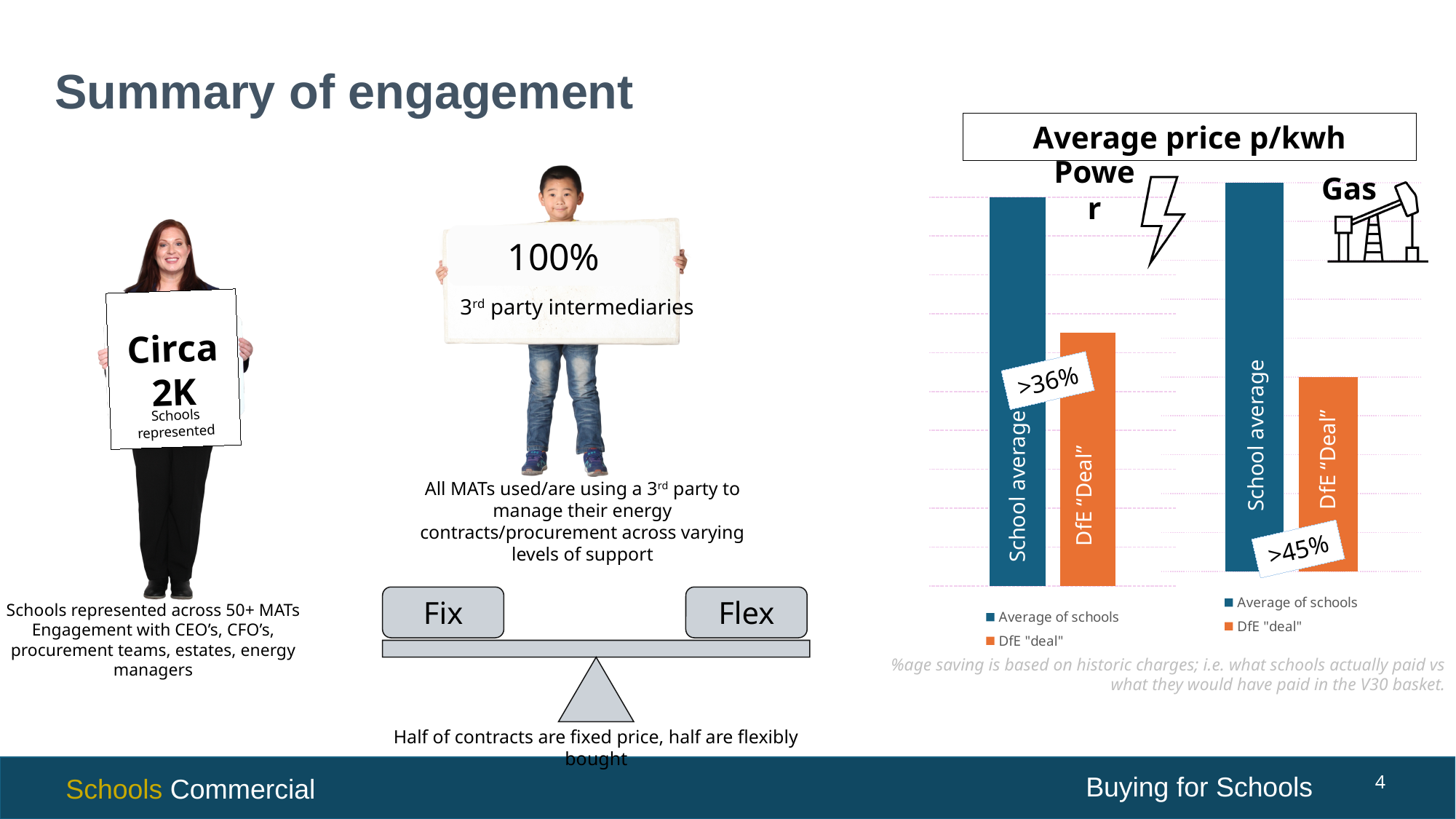
How many series does the legend of the Power chart list? 2 In the Power chart, which bar is the lowest? DfE "Deal" How many series does the legend of the Gas chart list? 2 In the Power chart, which bar is taller: School average or DfE "Deal"? School average In the Gas chart, which bar is the highest? School average What is the title shown above the Power and Gas charts? Average price p/kwh What kind of chart is used for the Gas chart? bar chart In the Gas chart, which bar is taller: School average or DfE "Deal"? School average What saving percentage is labelled on the Gas chart? >45% How many bars are plotted in the Gas chart? 2 What kind of chart is used for the Power chart? bar chart What saving percentage is labelled on the Power chart? >36%